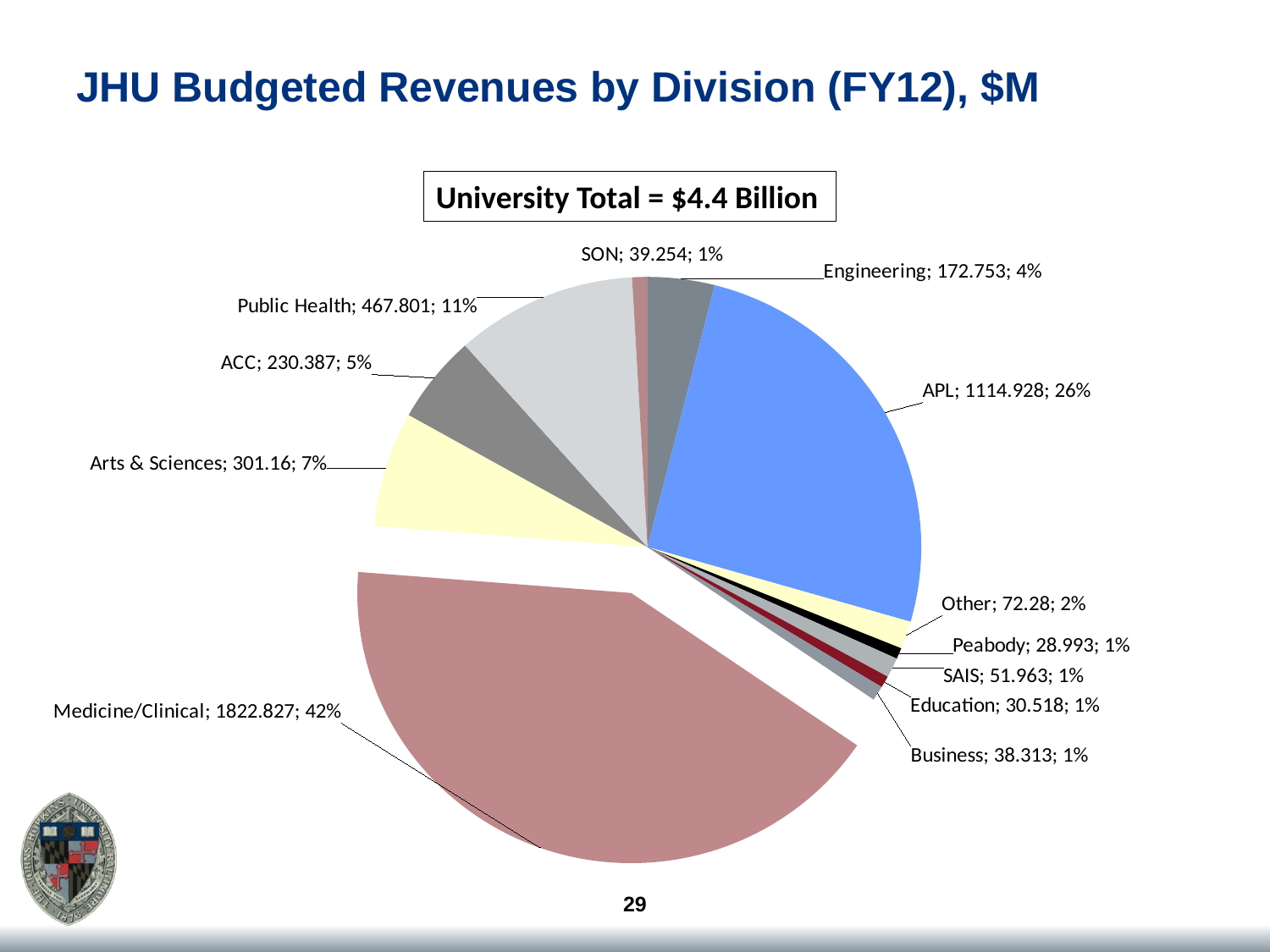
What is the title of the chart? JHU Budgeted Revenues by Division (FY12), $M What type of chart is shown on the slide? Pie chart Which division has the largest budgeted revenue? Medicine/Clinical What share of the pie does Medicine/Clinical represent? 42% Which has a larger budgeted revenue, Arts & Sciences or ACC? Arts & Sciences What is the difference in budgeted revenue between Medicine/Clinical and APL? 707.899 What is the budgeted revenue for Public Health? 467.801 Which division has the smallest budgeted revenue? Peabody What is the university total stated on the slide? $4.4 Billion What share of the pie does Engineering represent? 4% How many divisions (slices) are shown in the pie chart? 12 What is the budgeted revenue for APL? 1114.928